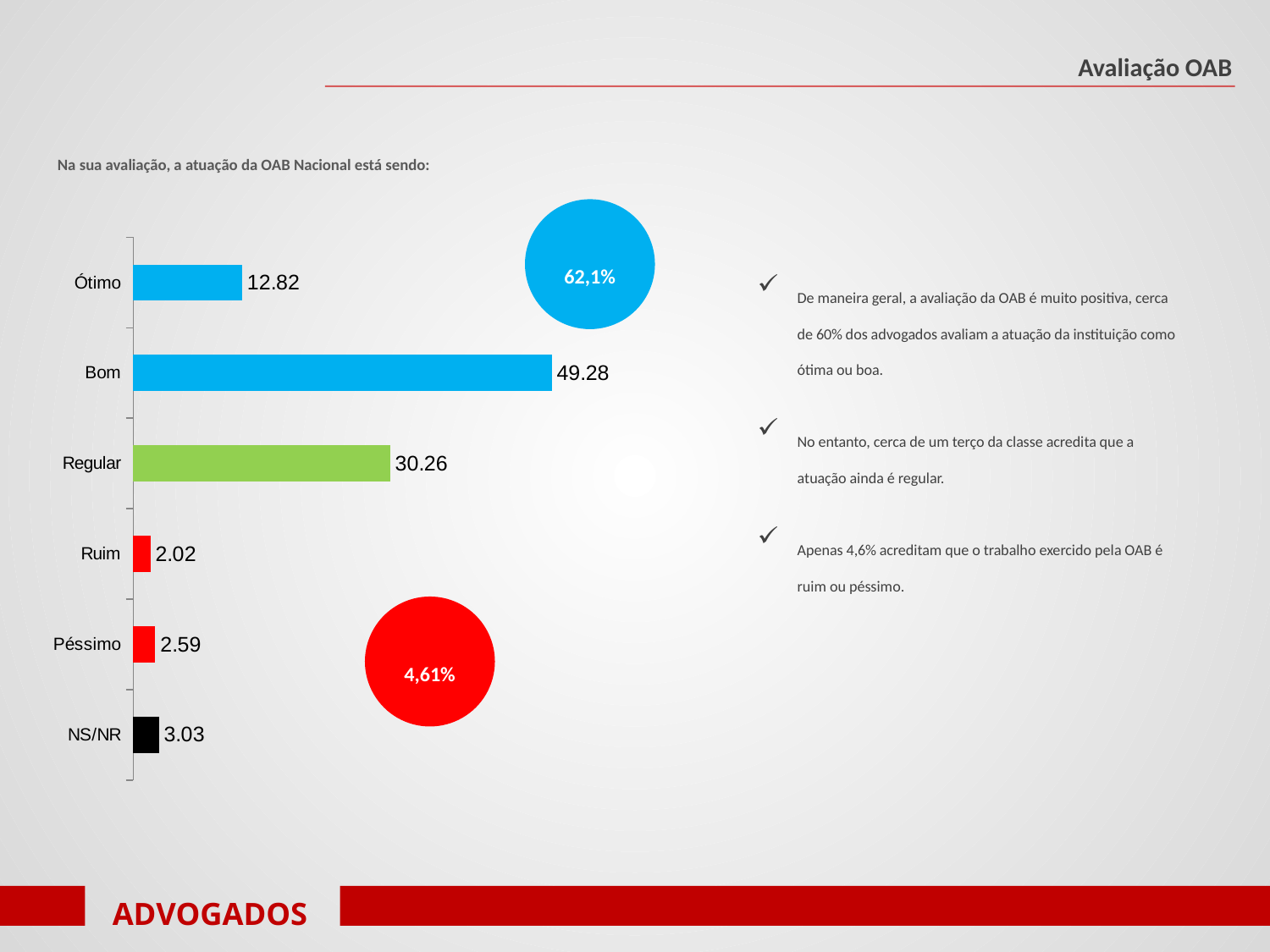
Which category has the highest value? Bom What is the difference between the values for Péssimo and Ruim? 0.57 What is the value for NS/NR? 3.03 What is the value for Regular? 30.26 Which is larger, the value for Ótimo or the value for NS/NR? Ótimo How many categories are shown in the bar chart? 6 What percentage is shown in the blue circle next to the chart? 62,1% What kind of chart is shown on the slide? Bar chart What is the value for Ótimo? 12.82 Which category has the lowest value? Ruim What is the difference between the values for Bom and Regular? 19.02 What is the value for Bom? 49.28